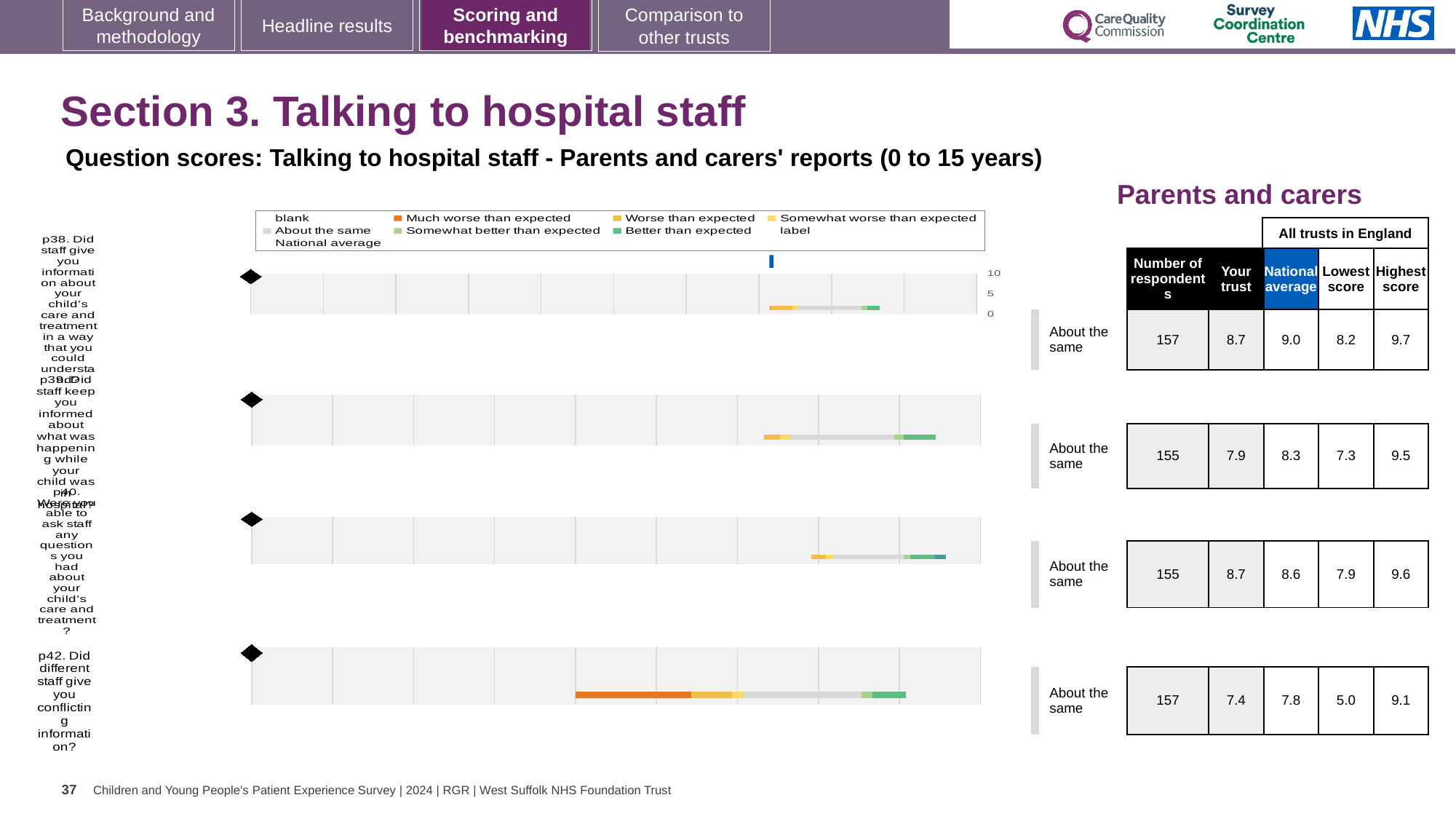
In the table beside the chart, what is the lowest score across all trusts in England for p42? 5.0 Which question has the lowest 'Your trust' score in the table beside the chart? p42 What benchmark label is shown next to each of the four bars? About the same How many entries does the chart legend list? 9 How many survey questions (categories) are plotted in the chart? 4 What is the difference between the highest score (9.7) and the lowest score (8.2) for p38 in the table? 1.5 In the table beside the chart, what is the national average for p42 (conflicting information)? 7.8 In the table beside the chart, what is the 'Your trust' score for p38 (information about your child's care and treatment)? 8.7 Which question has the highest 'Your trust' score in the table beside the chart? p38 and p40 (8.7) Which legend entry is shown in orange? Much worse than expected In the table beside the chart, how many respondents answered p39? 155 What kind of chart is used to show the question scores on this slide? bar chart